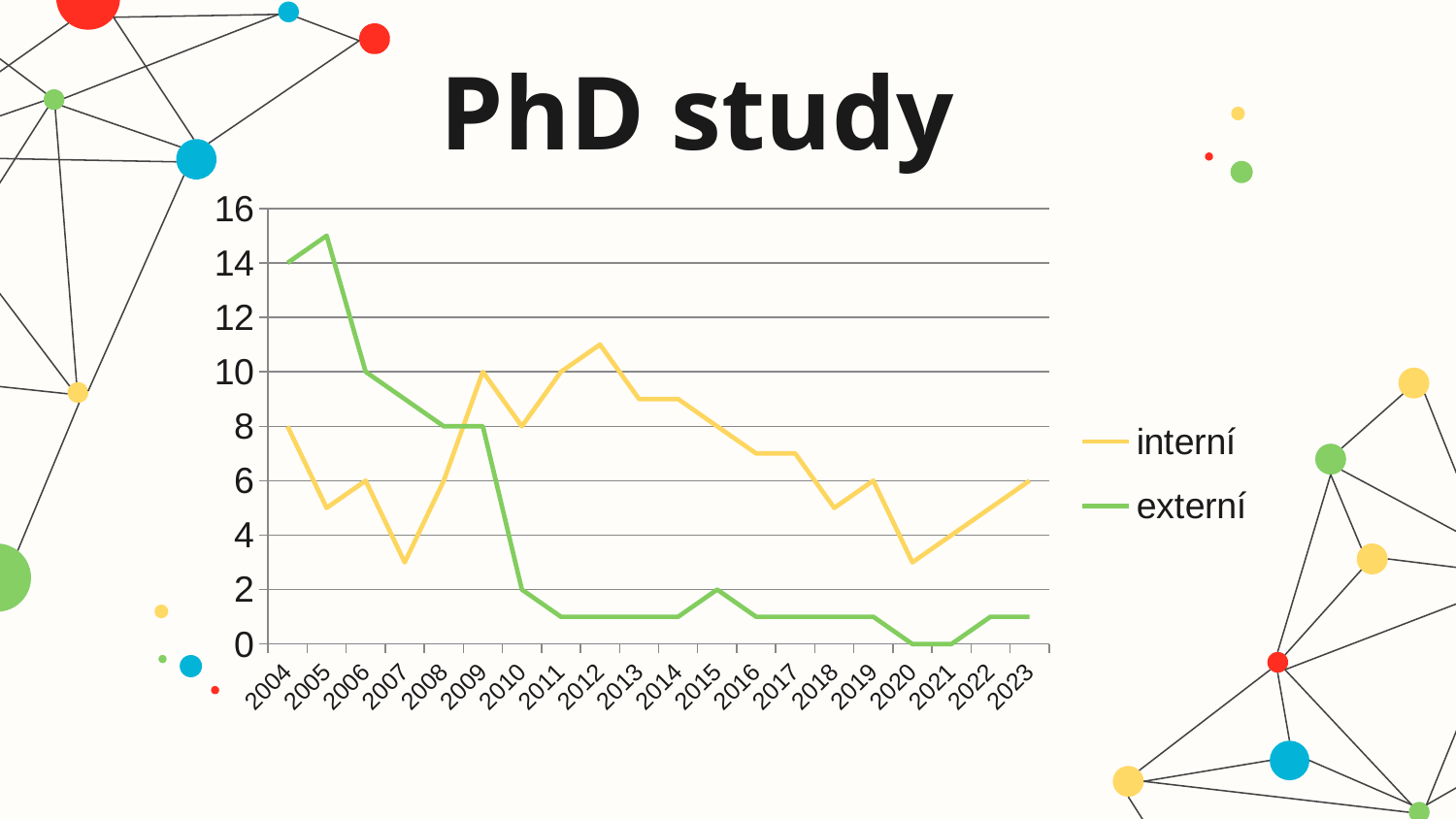
What is the value for externí in 2006? 10 Is the value for interní in 2012 greater or less than 10? greater What is the value for externí in 2004? 14 What type of chart is shown on the slide? line chart What is the value for interní in 2023? 6 In which year does externí reach its highest value? 2005 Which series has the larger value in 2023, interní or externí? interní What is the value for interní in 2009? 10 How many series does the legend list? 2 What is the difference between the externí values in 2004 and 2006? 4 In which year does interní reach its highest value? 2012 How many years are shown on the x axis? 20